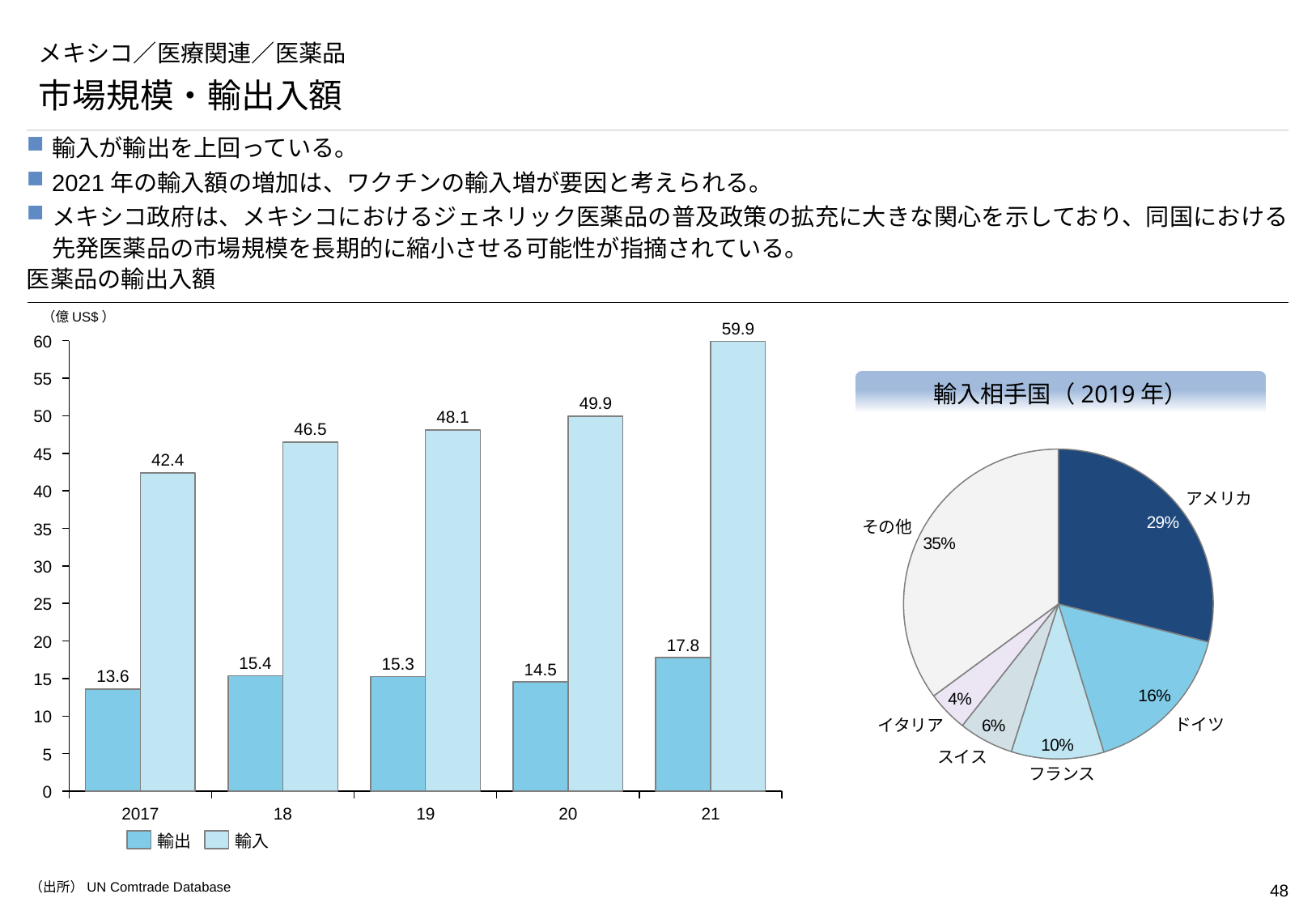
In the pie chart 輸入相手国（2019年）, what share does アメリカ have? 29% In the bar chart on the left, how many years are shown on the x axis? 5 In the bar chart on the left, which is larger in 20: 輸出 or 輸入? 輸入 In the bar chart on the left, what is the value of 輸出 for 21? 17.8 In the bar chart on the left, which year has the lowest 輸出 value? 2017 In the bar chart on the left, what is the difference between 輸入 and 輸出 in 21? 42.1 In the pie chart 輸入相手国（2019年）, how many slices are there? 6 In the pie chart 輸入相手国（2019年）, which country has the smallest share? イタリア In the bar chart on the left, how many series does the legend list? 2 In the bar chart on the left, which year has the highest 輸入 value? 21 What kind of chart is the chart on the left? bar chart